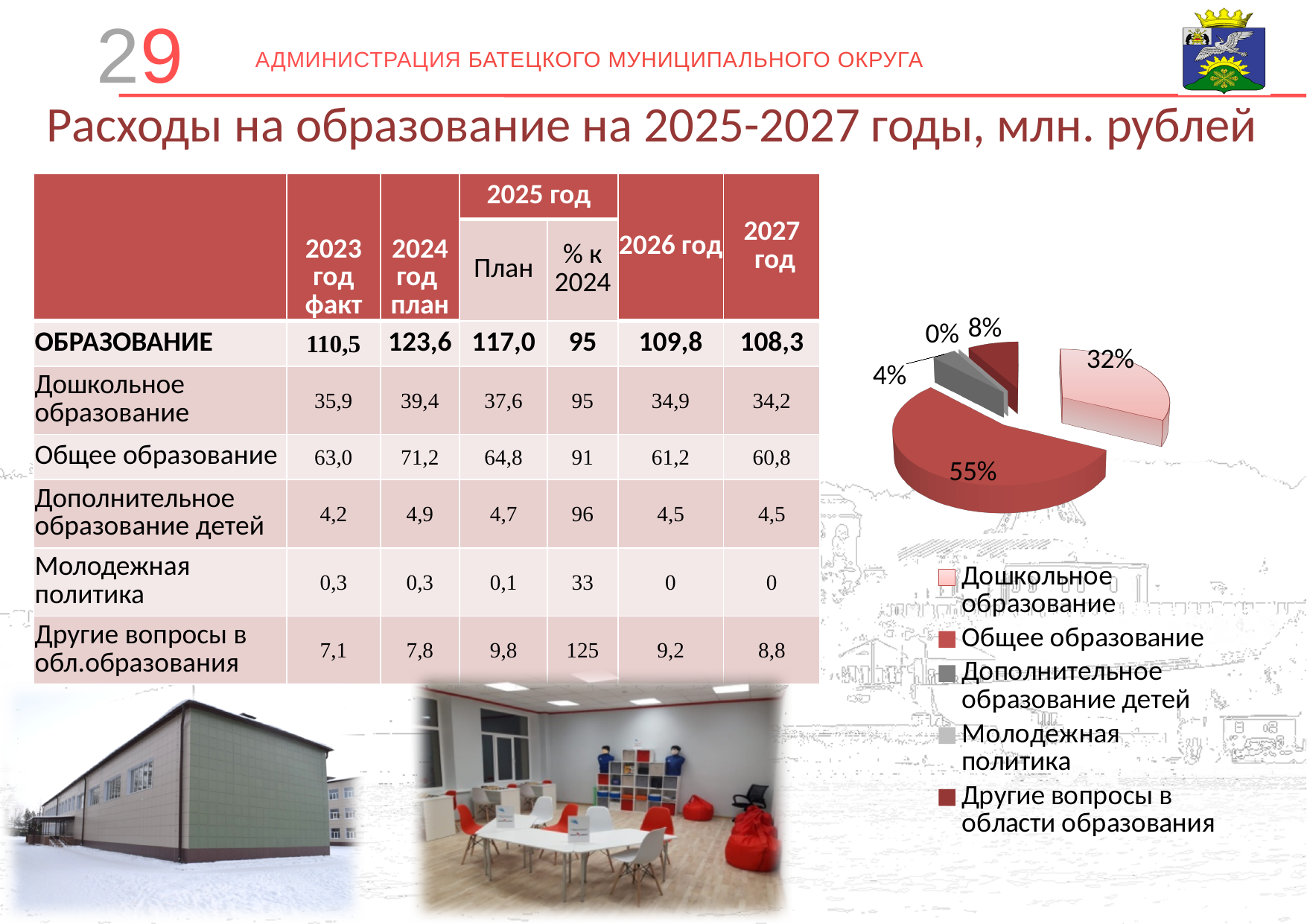
In the pie chart, what share does Общее образование have? 55% Which category has the largest slice in the pie chart? Общее образование In the pie chart, which category is shown in the lightest pink colour? Дошкольное образование In the pie chart, what share does Дополнительное образование детей have? 4% Which category has the smallest slice in the pie chart? Молодежная политика In the pie chart, what is the difference in percentage points between the share of Общее образование and the share of Дошкольное образование? 23 In the pie chart, what share does Дошкольное образование have? 32% In the pie chart, what share does Другие вопросы в области образования have? 8% How many categories does the pie chart legend list? 5 What kind of chart is shown on the slide? pie chart In the pie chart, what share does Молодежная политика have? 0% In the pie chart, which is larger: the share of Дошкольное образование or the share of Другие вопросы в области образования? Дошкольное образование